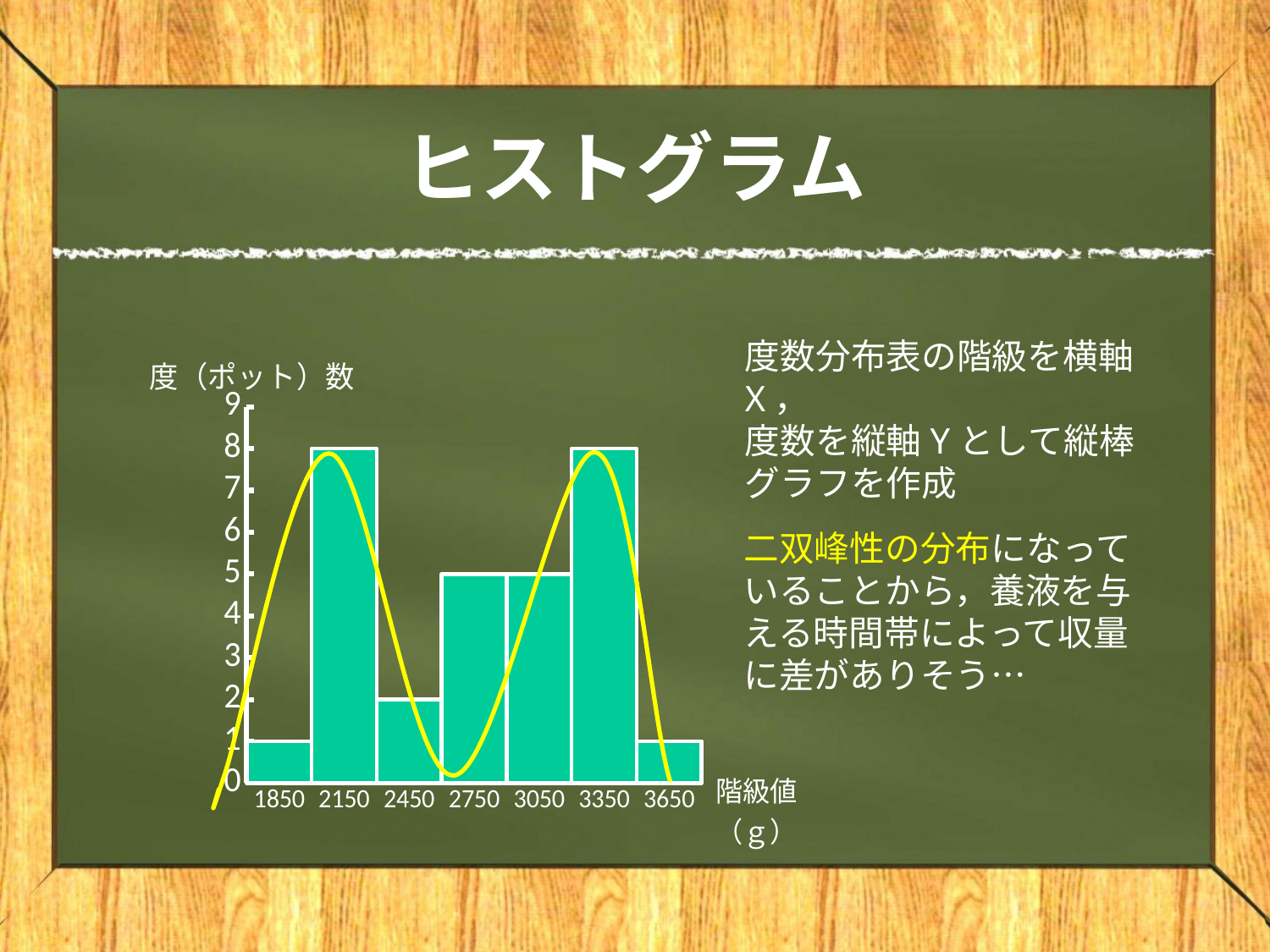
What kind of chart is shown on the slide? bar chart (histogram) What is the difference between the values for 2150 and 2450? 6 Is the value for 2750 greater or less than 4? greater Which is larger, the value for 2150 or the value for 2450? 2150 Which is larger, the value for 3050 or the value for 3650? 3050 What is the value for the 2150 class in the histogram? 8 What is the value for the 3650 class? 1 What is the value for the 2750 class? 5 What is the value for the 3350 class? 8 How many classes (bars) are shown on the x axis? 7 What is the value for the 2450 class? 2 What is the label of the vertical axis? 度（ポット）数